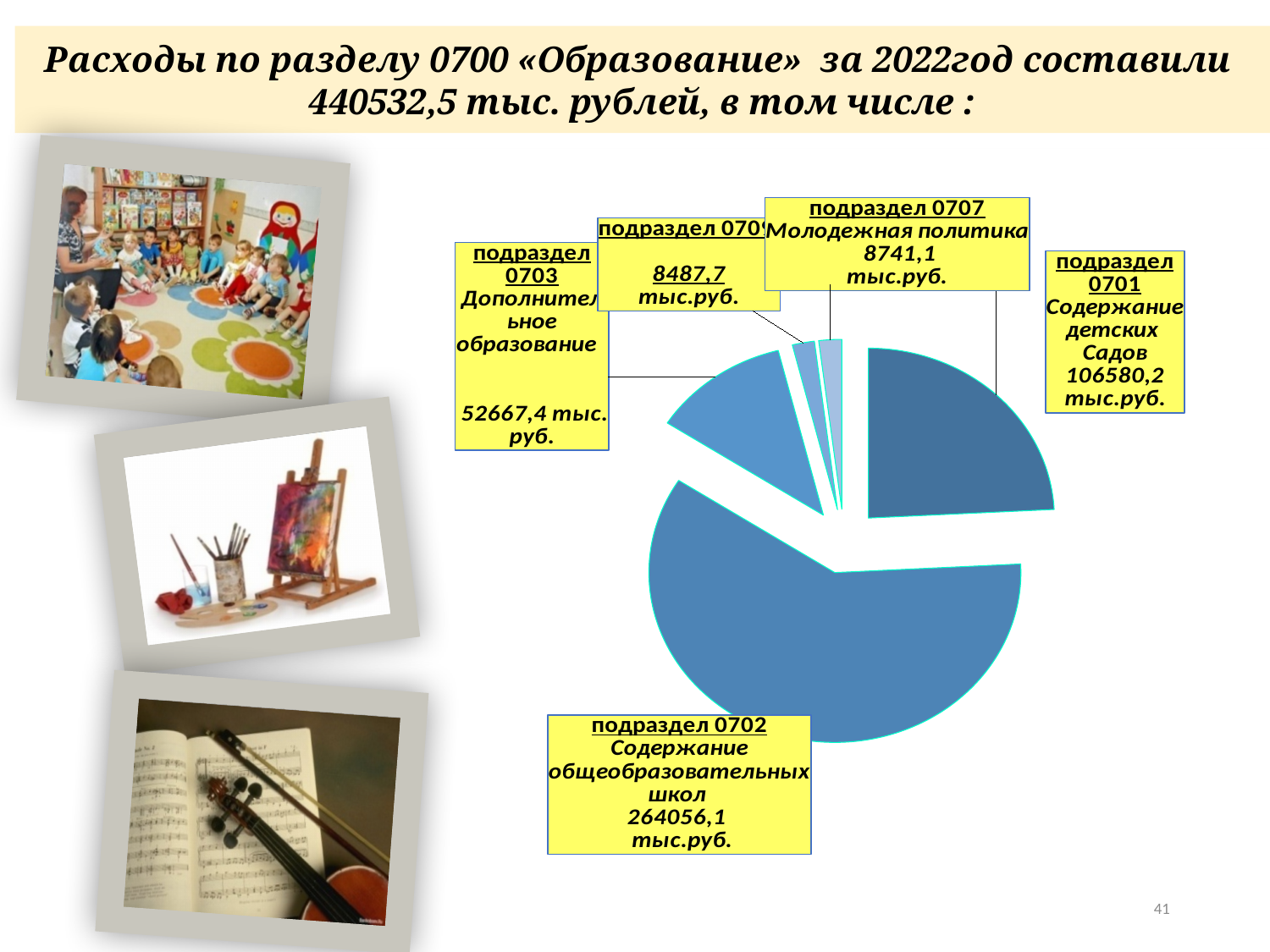
What is the value for подраздел 0701 (Содержание детских садов)? 106580,2 тыс.руб. Which budget section and year does the slide title say the chart covers? раздел 0700 «Образование», 2022 год Which is larger: the value for подраздел 0703 or подраздел 0707? подраздел 0703 What is the total of all expenditures shown in the pie chart, according to the slide title? 440532,5 тыс. рублей What is the difference between the values for подраздел 0702 and подраздел 0701? 157475,9 тыс.руб. What is the value for подраздел 0702 (Содержание общеобразовательных школ)? 264056,1 тыс.руб. Which subsection has the largest slice of the pie chart? подраздел 0702 (Содержание общеобразовательных школ) What is the value for подраздел 0707 (Молодежная политика)? 8741,1 тыс.руб. What is the value for подраздел 0703 (Дополнительное образование)? 52667,4 тыс.руб. What type of chart is shown on the slide? pie chart What is the difference between the values for подраздел 0701 and подраздел 0703? 53912,8 тыс.руб. How many slices does the pie chart have? 5